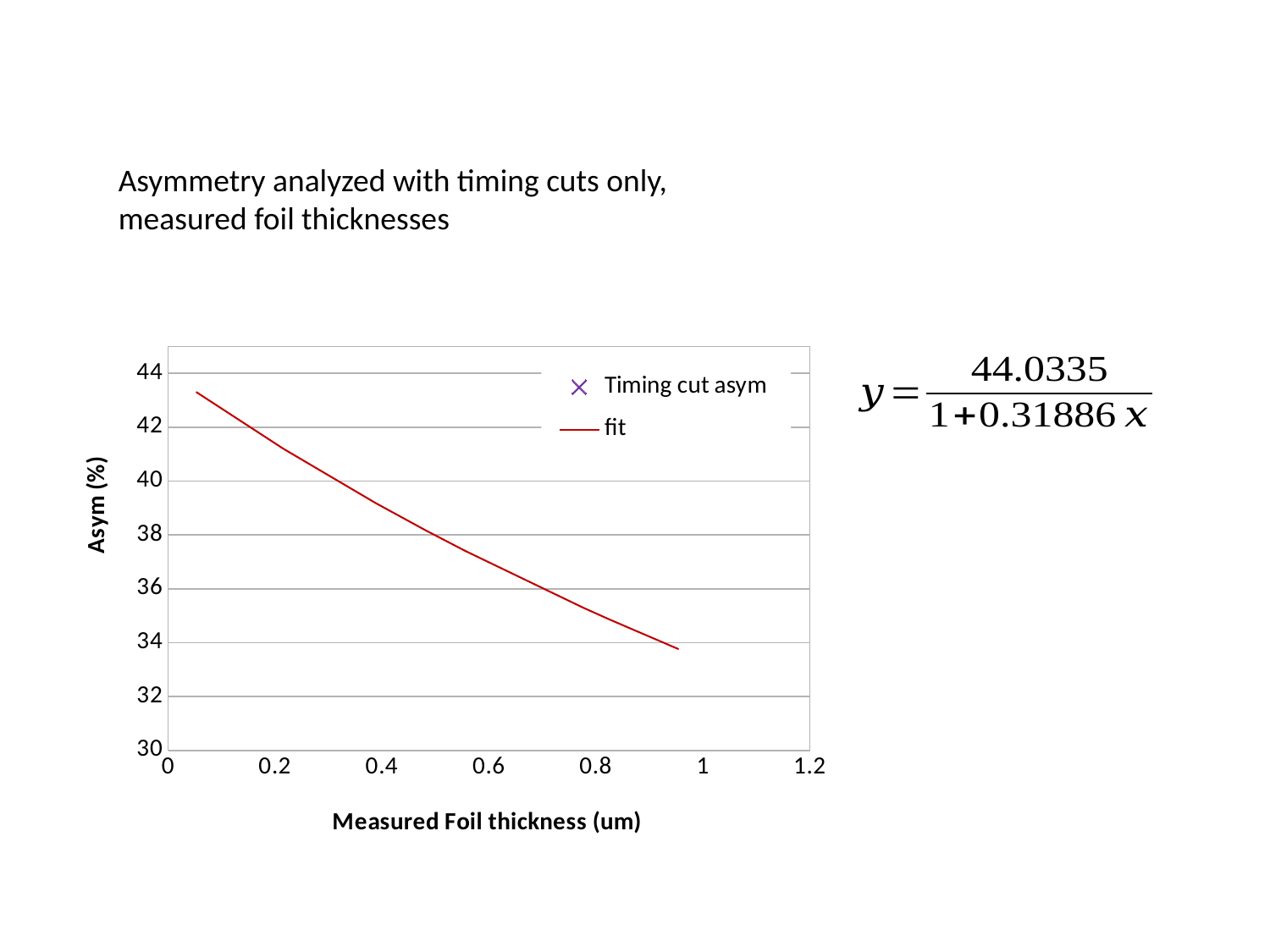
What is the maximum value shown on the y axis of the chart? 44 Is the value of the fit line at a foil thickness of 0.8 um greater or less than 36? less Is the value of the fit line at a foil thickness of 0.4 um greater or less than 40? less How many series does the chart legend list? 2 What is the title of the x axis? Measured Foil thickness (um) Is the fit line value at a foil thickness of 0.2 um larger or smaller than its value at 0.8 um? larger Is the value of the fit line at a foil thickness of 0.6 um greater or less than 36? greater What kind of chart is shown on the slide? line chart What are the two entries in the chart legend? Timing cut asym, fit Does the fit line rise or fall as the measured foil thickness increases? fall